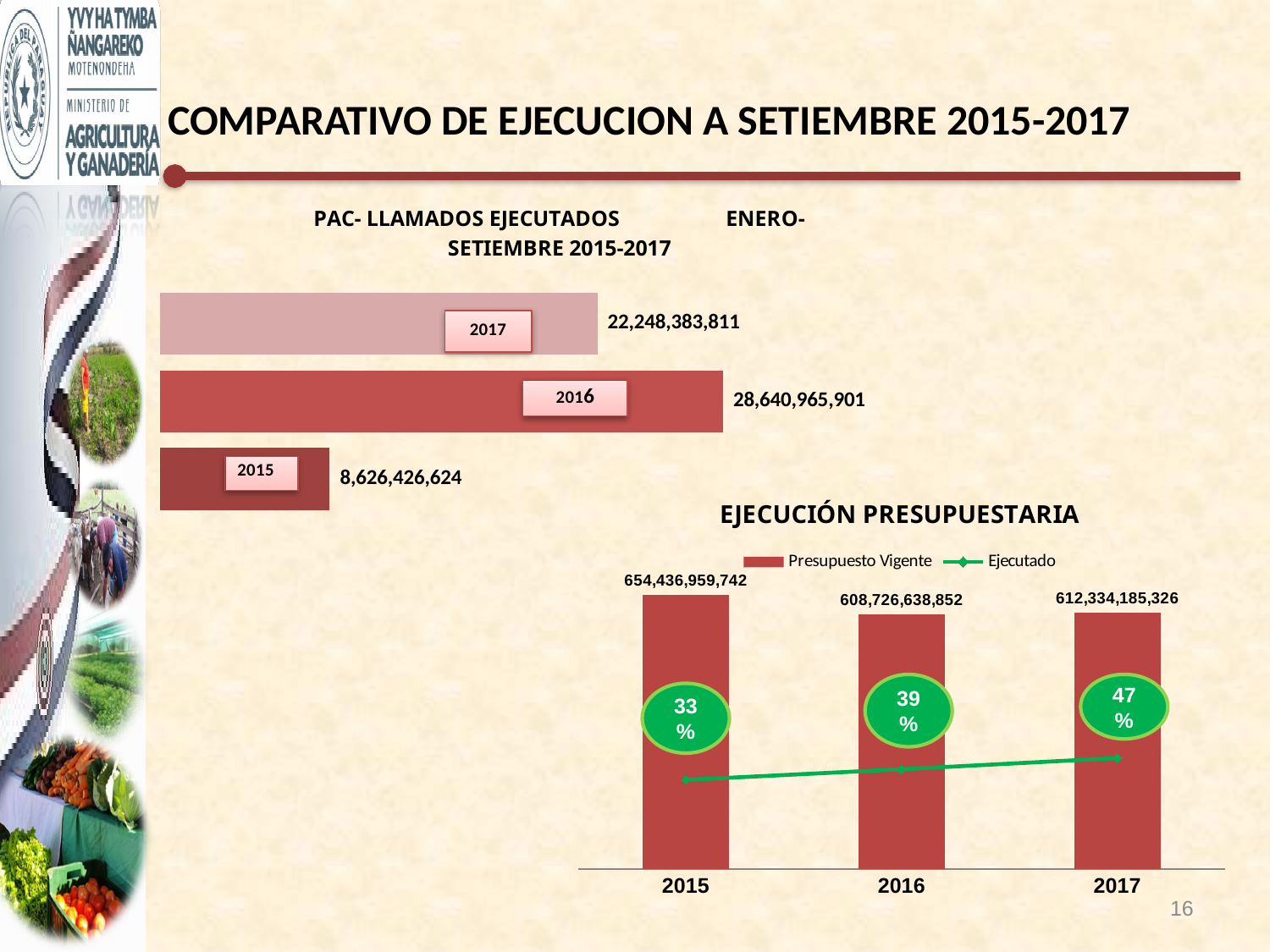
In the EJECUCIÓN PRESUPUESTARIA chart, what is the difference between the Presupuesto Vigente for 2015 and 2016? 45,710,320,890 In the PAC- LLAMADOS EJECUTADOS chart, what is the value for 2015? 8,626,426,624 In the PAC- LLAMADOS EJECUTADOS chart, which year has the lowest value? 2015 In the EJECUCIÓN PRESUPUESTARIA chart, which year has the highest Presupuesto Vigente? 2015 In the PAC- LLAMADOS EJECUTADOS chart, which year has the highest value? 2016 In the PAC- LLAMADOS EJECUTADOS chart, what is the value for 2016? 28,640,965,901 In the EJECUCIÓN PRESUPUESTARIA chart, what is the Presupuesto Vigente value for 2015? 654,436,959,742 In the EJECUCIÓN PRESUPUESTARIA chart, what is the Ejecutado percentage for 2017? 47% In the EJECUCIÓN PRESUPUESTARIA chart, does the Ejecutado percentage rise or fall from 2015 to 2017? Rise In the PAC- LLAMADOS EJECUTADOS chart, what is the difference between the 2016 and 2017 values? 6,392,582,090 How many series does the legend of the EJECUCIÓN PRESUPUESTARIA chart list? 2 What kind of chart is the PAC- LLAMADOS EJECUTADOS chart? Bar chart